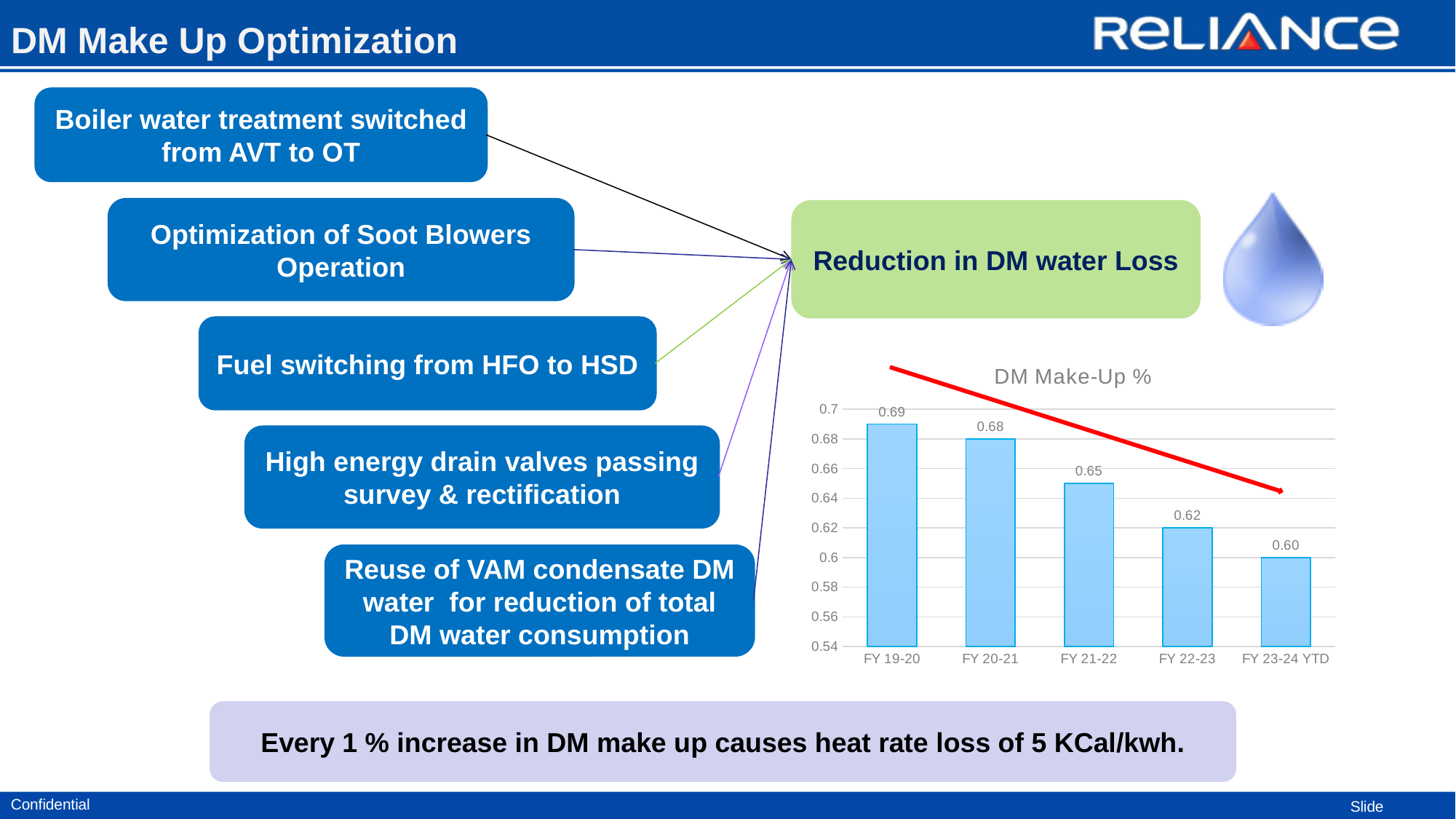
Which period has the lowest DM Make-Up %? FY 23-24 YTD Which fiscal year has the highest DM Make-Up %? FY 19-20 Does the DM Make-Up % rise or fall from FY 19-20 to FY 23-24 YTD? Fall What is the difference in DM Make-Up % between FY 20-21 and FY 22-23? 0.06 What is the DM Make-Up % value for FY 21-22? 0.65 Which is larger, the DM Make-Up % for FY 20-21 or for FY 22-23? FY 20-21 What is the difference in DM Make-Up % between FY 19-20 and FY 23-24 YTD? 0.09 What is the DM Make-Up % value for FY 19-20? 0.69 Is the DM Make-Up % for FY 22-23 greater or less than 0.64? less How many fiscal periods are shown in the DM Make-Up % chart? 5 What type of chart is used to show DM Make-Up %? Bar chart What is the DM Make-Up % value for FY 23-24 YTD? 0.60